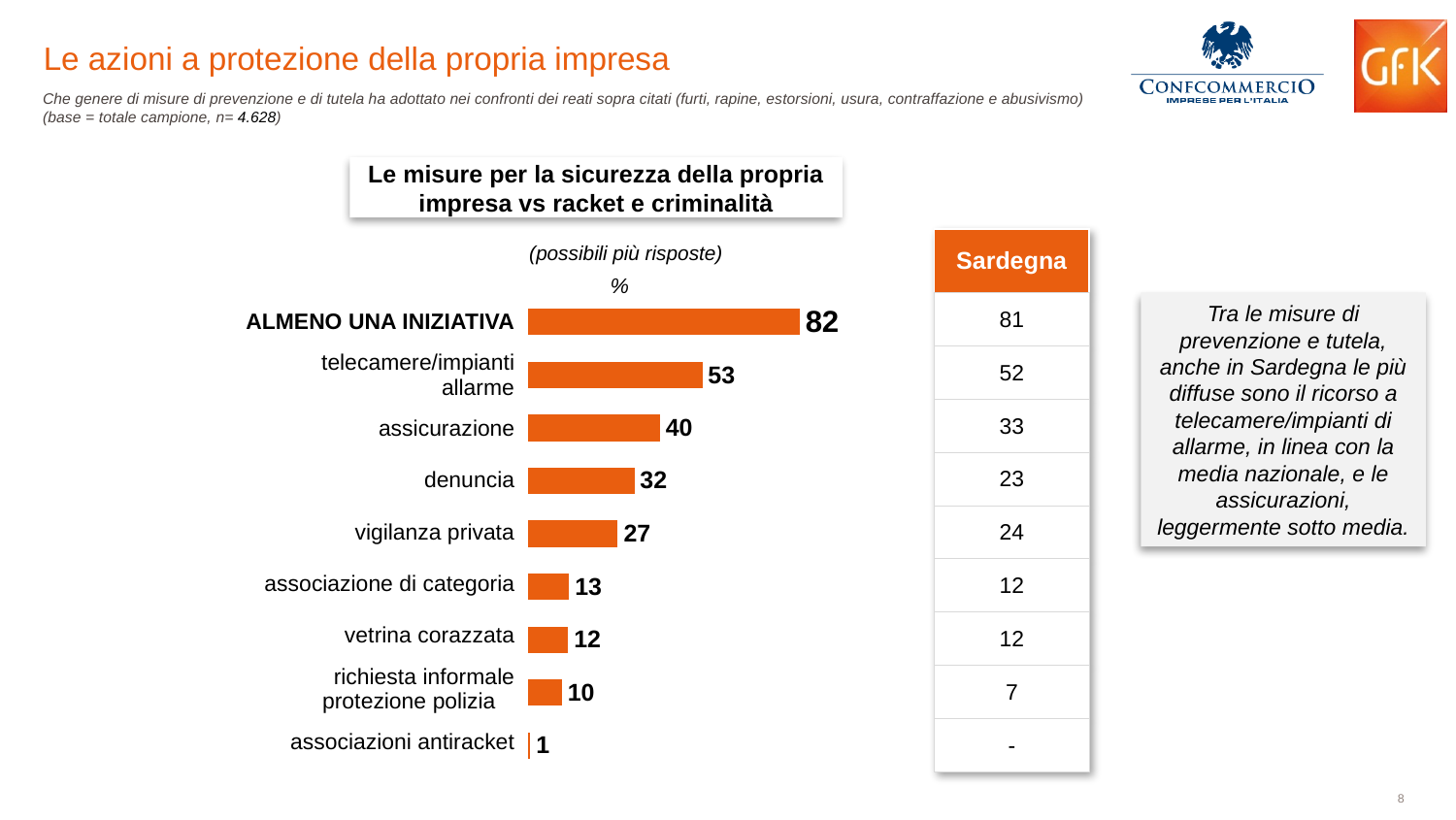
What is the value for vigilanza privata? 27 What is the difference between the values for ALMENO UNA INIZIATIVA and telecamere/impianti allarme? 29 How many categories are shown in the bar chart? 9 What is the value for associazioni antiracket? 1 Which category has the lowest value? associazioni antiracket What is the value for telecamere/impianti allarme? 53 What kind of chart is shown on the slide? bar chart What colour are the bars in the chart? orange Which is larger, the value for associazione di categoria or the value for richiesta informale protezione polizia? associazione di categoria Which category has the highest value? ALMENO UNA INIZIATIVA What is the difference between the values for assicurazione and denuncia? 8 What is the title of the chart? Le misure per la sicurezza della propria impresa vs racket e criminalità